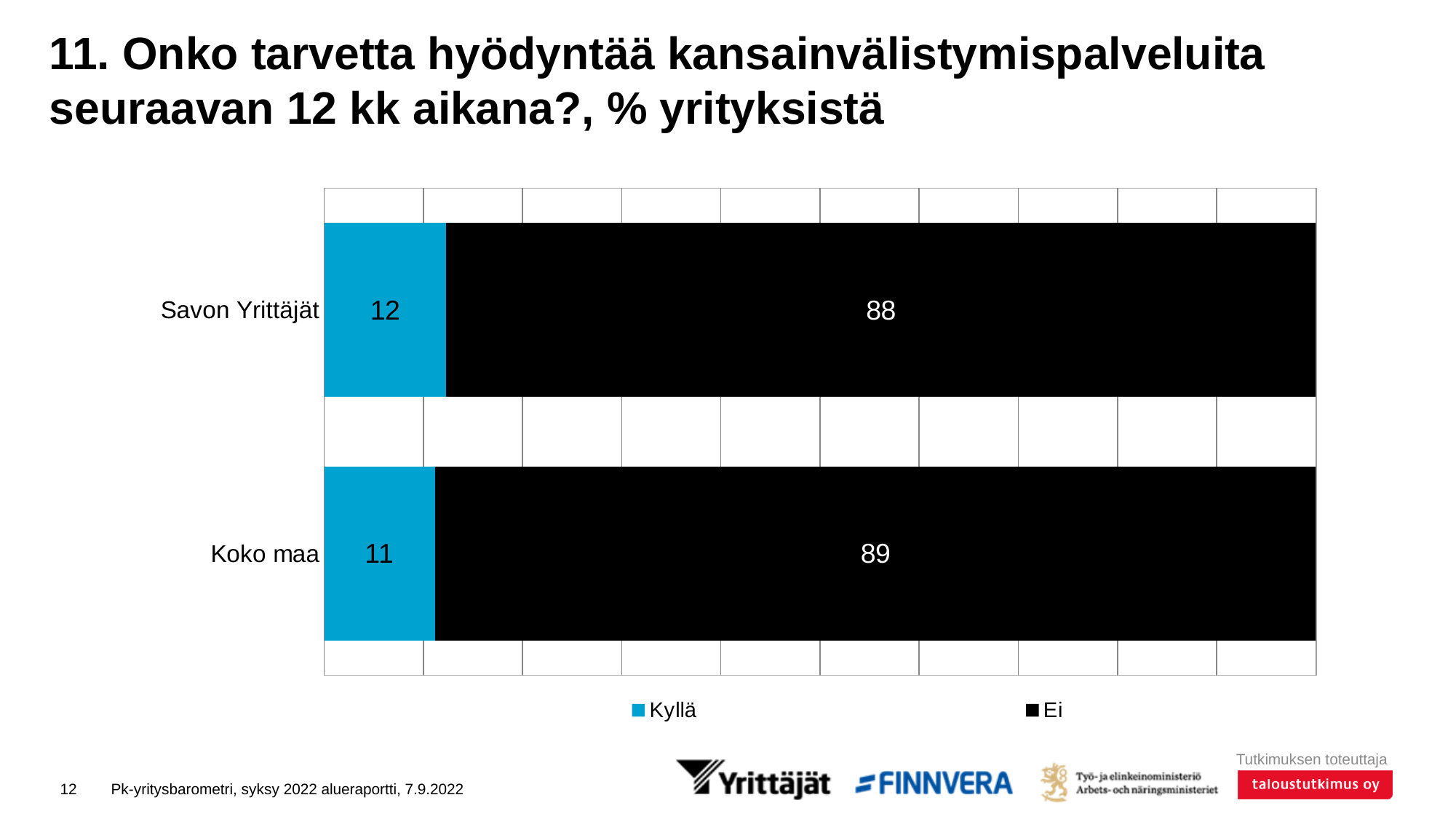
Which category has the lower Ei value? Savon Yrittäjät How many categories are shown on the chart? 2 What is the total of the stacked bar for Savon Yrittäjät? 100 Which category has the higher Kyllä value? Savon Yrittäjät What is the value for Ei for Savon Yrittäjät? 88 How many series does the legend list? 2 What is the value for Kyllä for Savon Yrittäjät? 12 What is the value for Kyllä for Koko maa? 11 What is the difference between the Ei values for Koko maa and Savon Yrittäjät? 1 What is the value for Ei for Koko maa? 89 Is the Kyllä value for Savon Yrittäjät larger or smaller than the Kyllä value for Koko maa? larger What kind of chart is shown on the slide? stacked bar chart